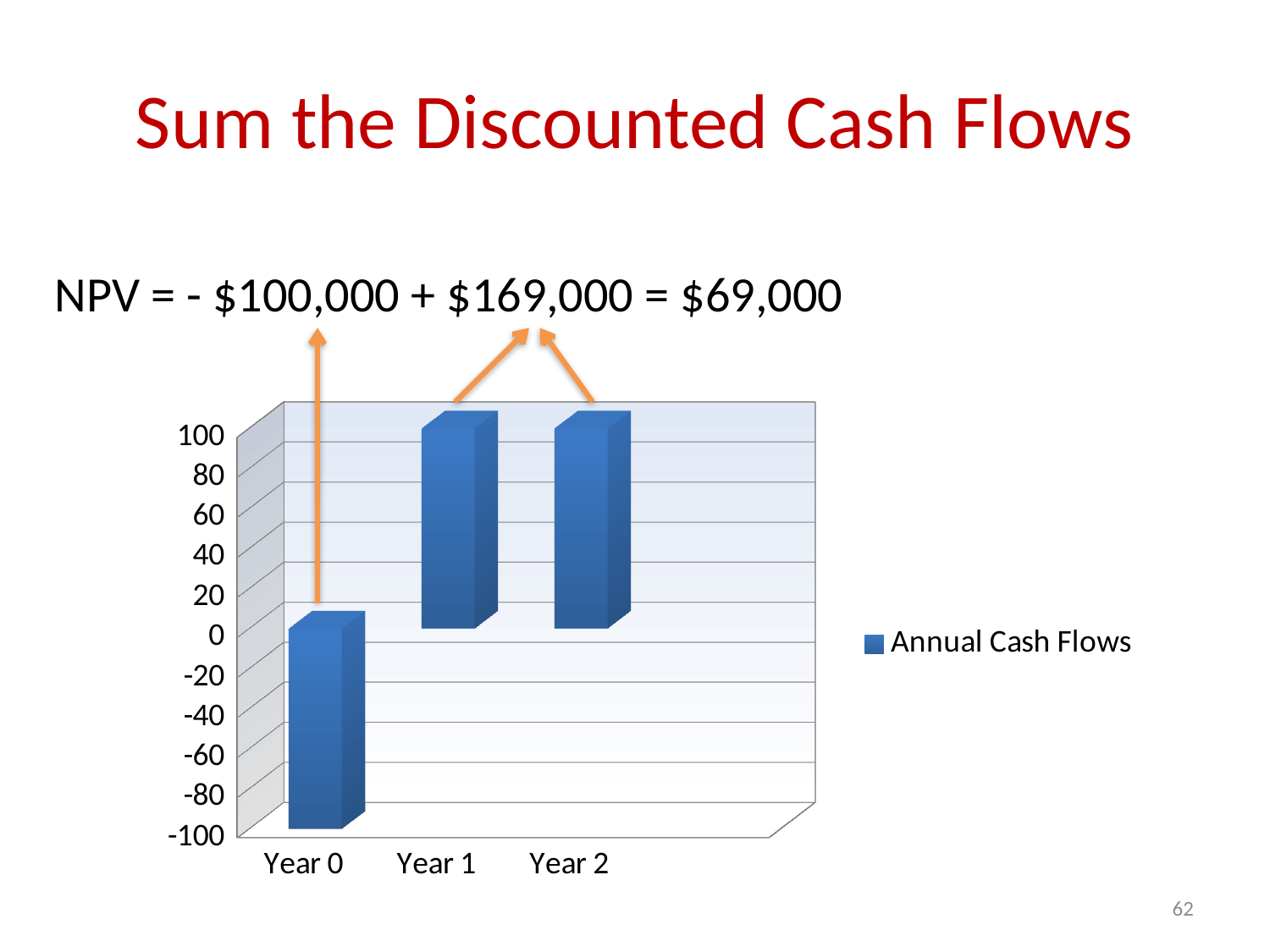
How many series does the chart legend list? 1 How many categories are shown on the x axis of the chart? 3 Which has the larger value, Year 0 or Year 1? Year 1 What kind of chart is shown on the slide? bar chart Which category has the lowest value in the chart? Year 0 Is the value for Year 0 greater or less than 0? less Is the value for Year 2 greater or less than 80? greater Do the values rise or fall from Year 0 to Year 1? rise Is the value for Year 0 greater or less than -80? less What is the name of the series shown in the chart legend? Annual Cash Flows What is the title of the slide containing the chart? Sum the Discounted Cash Flows